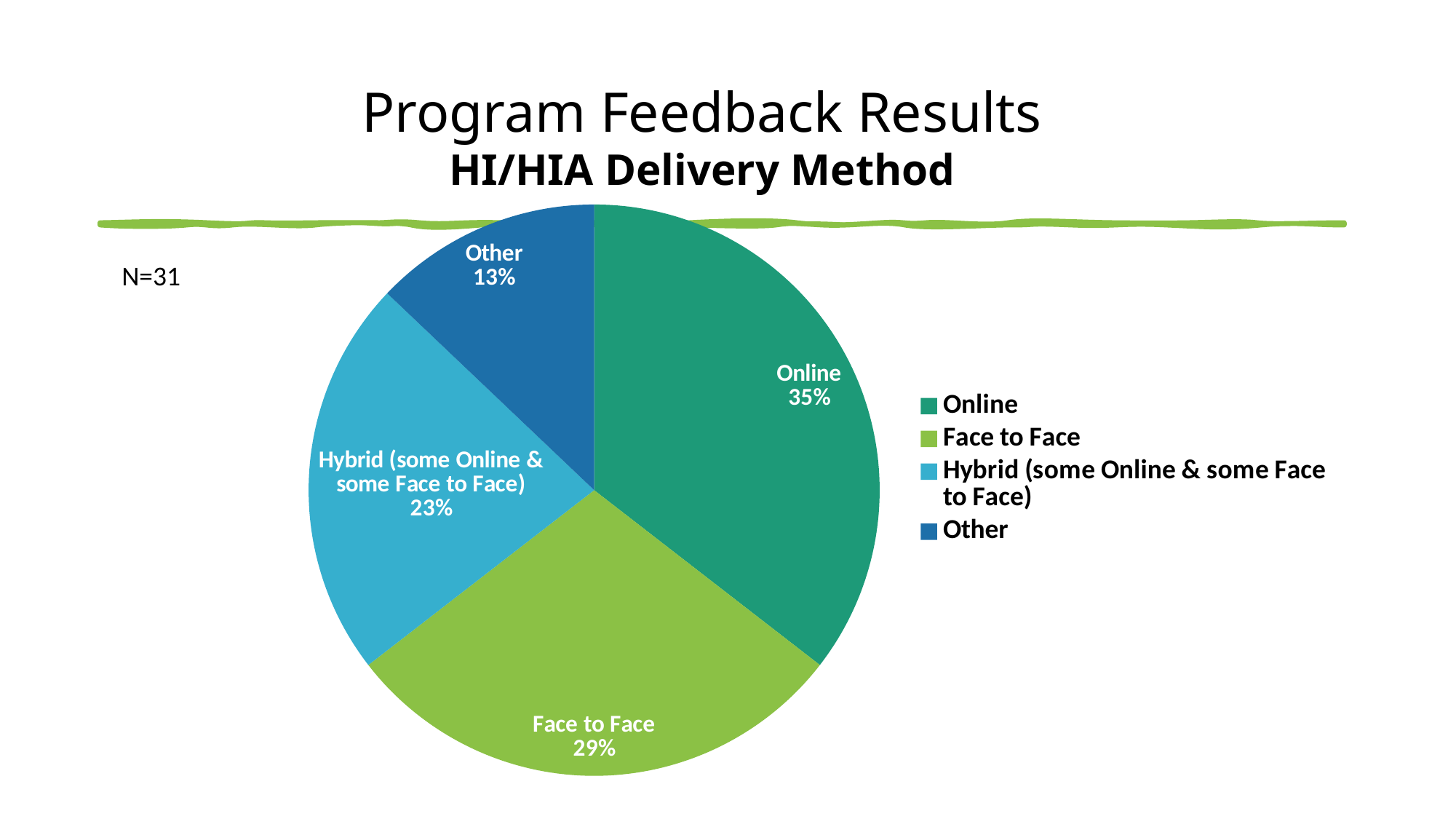
What percentage is shown for Other? 13% What is the difference in percentage points between Face to Face and Hybrid (some Online & some Face to Face)? 6 What percentage is shown for Face to Face? 29% What is the difference in percentage points between Online and Other? 22 How many slices does the pie chart have? 4 Which delivery method has the largest share of the pie? Online Which delivery method has the smallest share of the pie? Other What percentage of respondents chose Online as the delivery method? 35% What is the sample size (N) stated on the slide? 31 What percentage is shown for Hybrid (some Online & some Face to Face)? 23% Which is larger, the share for Face to Face or the share for Hybrid (some Online & some Face to Face)? Face to Face What kind of chart is shown on the slide? pie chart